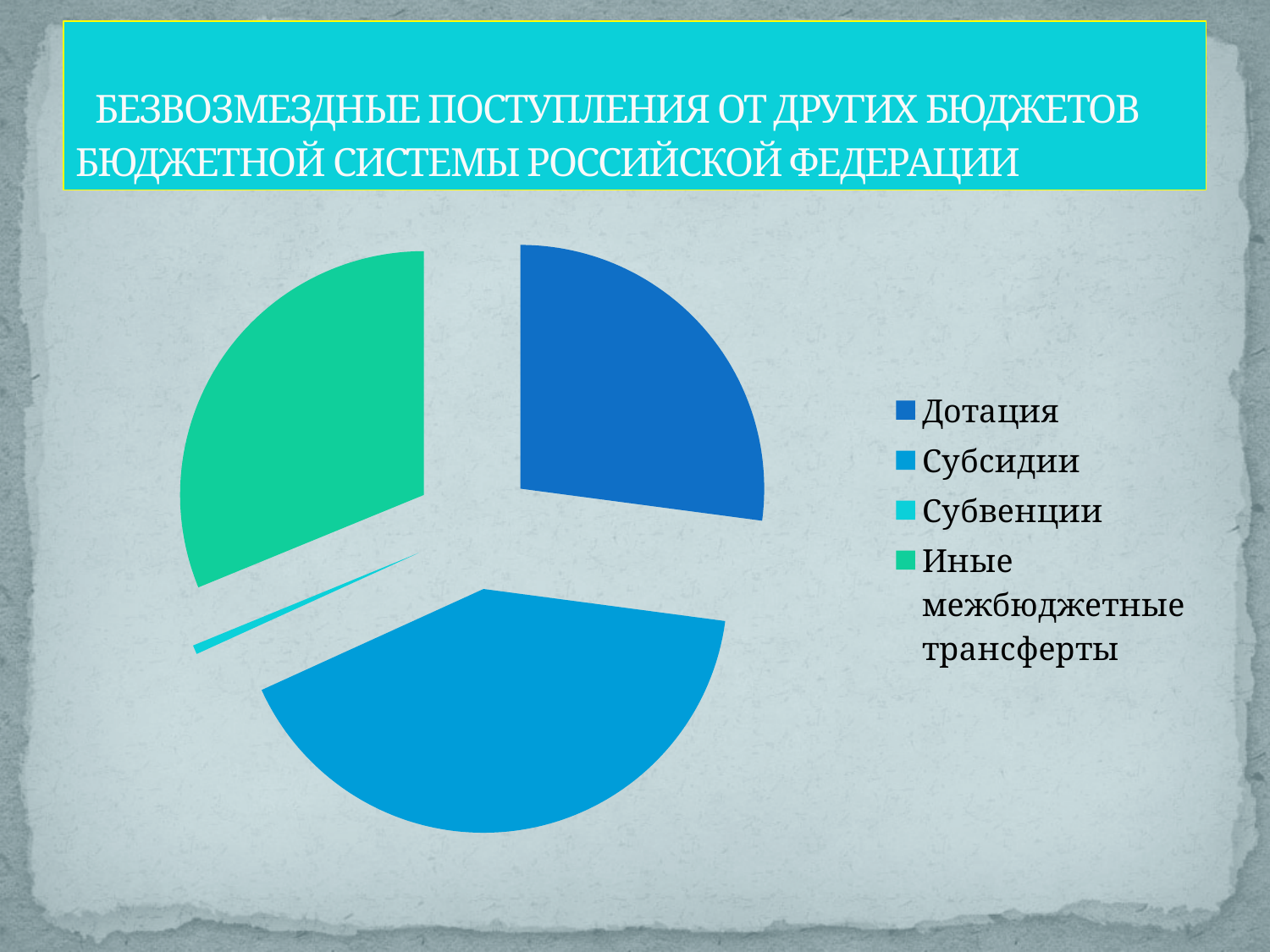
Which category is shown in green in the pie chart? Иные межбюджетные трансферты How many entries does the legend of the pie chart list? 4 Which category has the smallest slice of the pie chart? Субвенции Which slice is larger, Субсидии or Дотация? Субсидии How many slices does the pie chart have? 4 Which slice is larger, Иные межбюджетные трансферты or Субвенции? Иные межбюджетные трансферты Which slice is larger, Дотация or Субвенции? Дотация Which category has the largest slice of the pie chart? Субсидии What is the title of the slide containing the pie chart? БЕЗВОЗМЕЗДНЫЕ ПОСТУПЛЕНИЯ ОТ ДРУГИХ БЮДЖЕТОВ БЮДЖЕТНОЙ СИСТЕМЫ РОССИЙСКОЙ ФЕДЕРАЦИИ What kind of chart is shown on the slide? pie chart